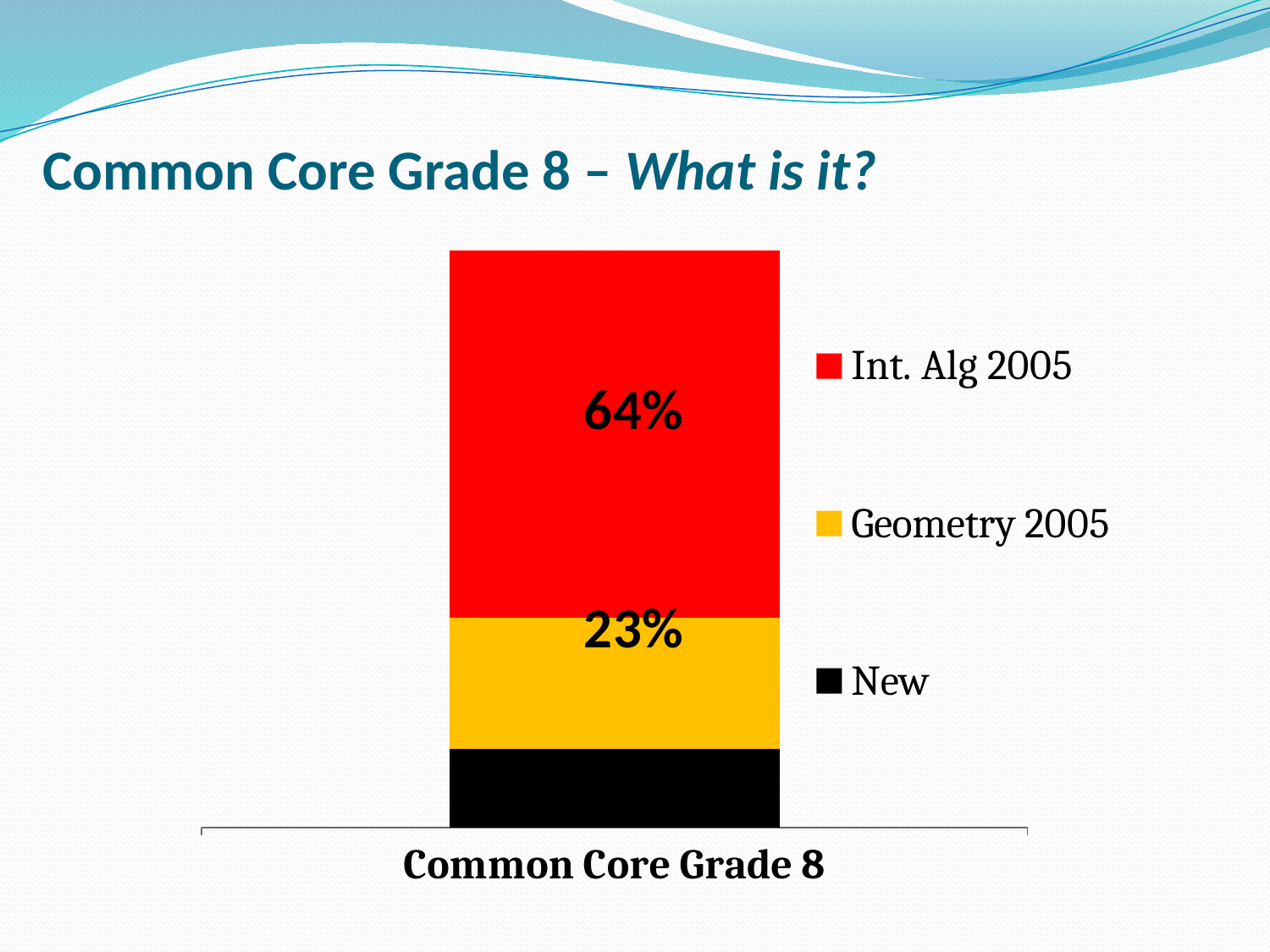
Which is larger, the Int. Alg 2005 share or the Geometry 2005 share? Int. Alg 2005 How many series does the legend list? 3 What colour represents the New series in the chart? Black Which series makes up the smallest part of the Common Core Grade 8 bar? New What percentage does the Int. Alg 2005 segment show for Common Core Grade 8? 64% What percentage does the Geometry 2005 segment show for Common Core Grade 8? 23% What kind of chart is shown on the slide? Stacked bar chart How many categories are shown on the x axis? 1 What is the difference between the Int. Alg 2005 share and the Geometry 2005 share? 41% What is the label of the single category on the x axis? Common Core Grade 8 Which series makes up the largest part of the Common Core Grade 8 bar? Int. Alg 2005